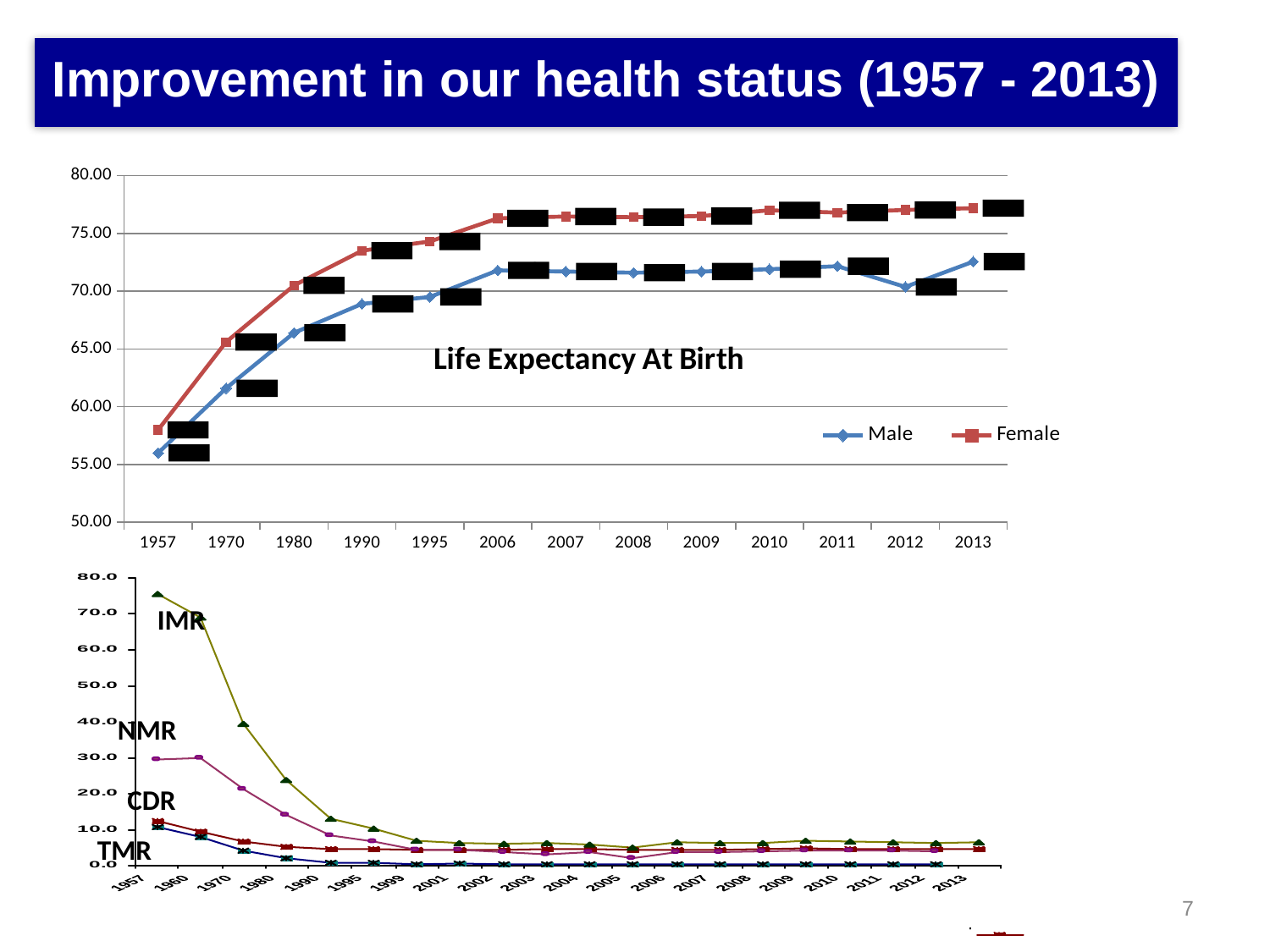
In the Life Expectancy At Birth chart, do the Female values generally rise or fall from 1957 to 2013? rise In the Life Expectancy At Birth chart, how many series does the legend list? 2 In the bottom chart, do the IMR values rise or fall from 1957 to 2013? fall What is the title of the top chart? Life Expectancy At Birth In the bottom chart, is the IMR value for 1957 greater or less than 70.0? greater In the bottom chart, in which year is the IMR series highest? 1957 In the Life Expectancy At Birth chart, is the Female value for 2013 greater or less than 75.00? greater In the Life Expectancy At Birth chart, in which year is the Female series lowest? 1957 In the Life Expectancy At Birth chart, what type of chart is used? line chart In the Life Expectancy At Birth chart, is the Male value for 1957 greater or less than 60.00? less In the Life Expectancy At Birth chart, which series is higher in 2013, Male or Female? Female In the Life Expectancy At Birth chart, how many years are shown on the x axis? 13